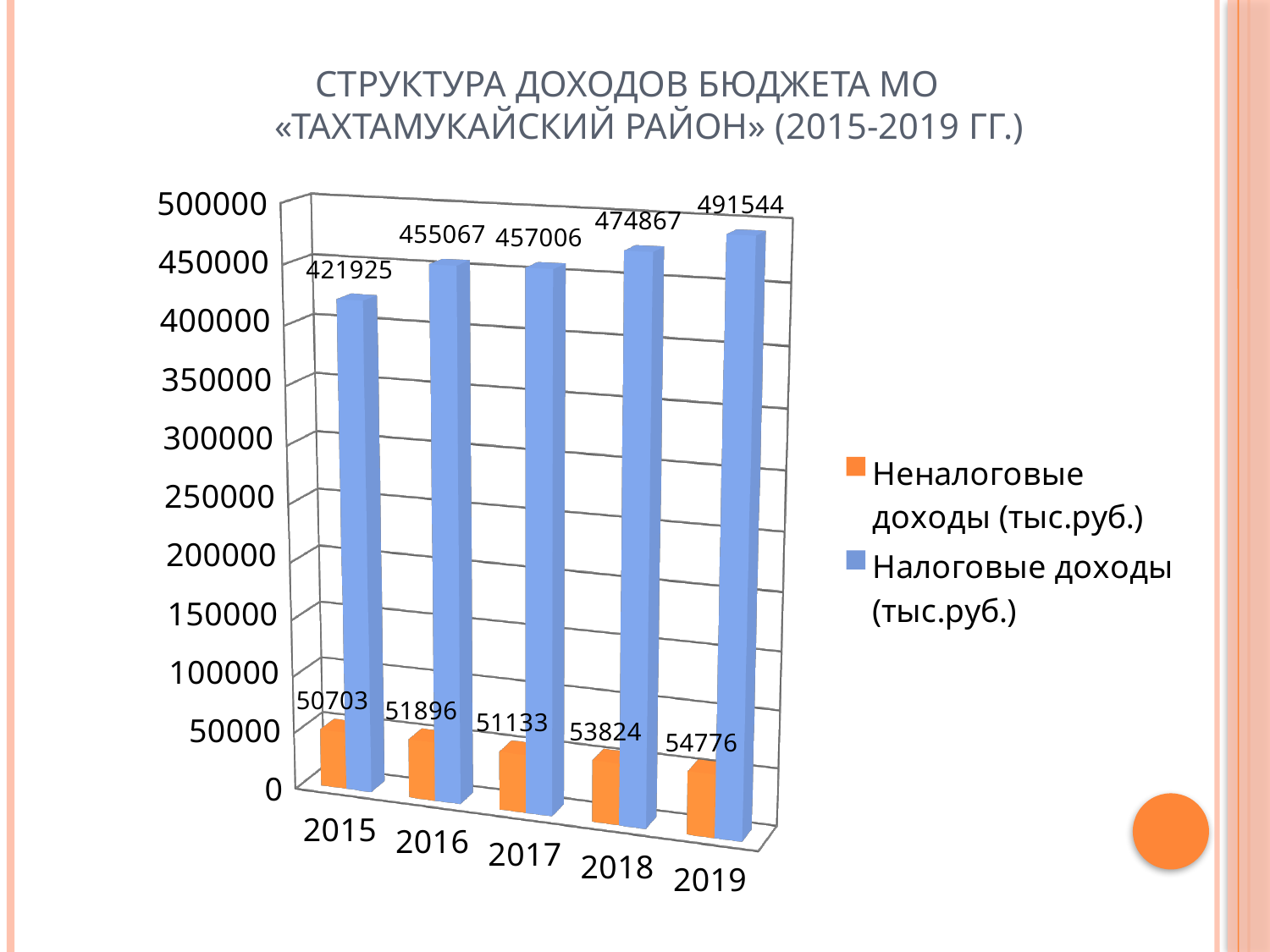
In which year is Неналоговые доходы (тыс.руб.) the lowest? 2015 What is the value of Неналоговые доходы (тыс.руб.) for 2015? 50703 Which is larger: Неналоговые доходы (тыс.руб.) in 2016 or in 2017? 2016 How many years are shown on the x axis? 5 How many series does the legend list? 2 Does Налоговые доходы (тыс.руб.) rise or fall from 2015 to 2019? Rise What is the value of Налоговые доходы (тыс.руб.) for 2017? 457006 In which year is Налоговые доходы (тыс.руб.) the highest? 2019 What kind of chart is shown on the slide? Bar chart What is the value of Неналоговые доходы (тыс.руб.) for 2018? 53824 What is the difference between Налоговые доходы (тыс.руб.) in 2019 and in 2015? 69619 What is the value of Налоговые доходы (тыс.руб.) for 2019? 491544